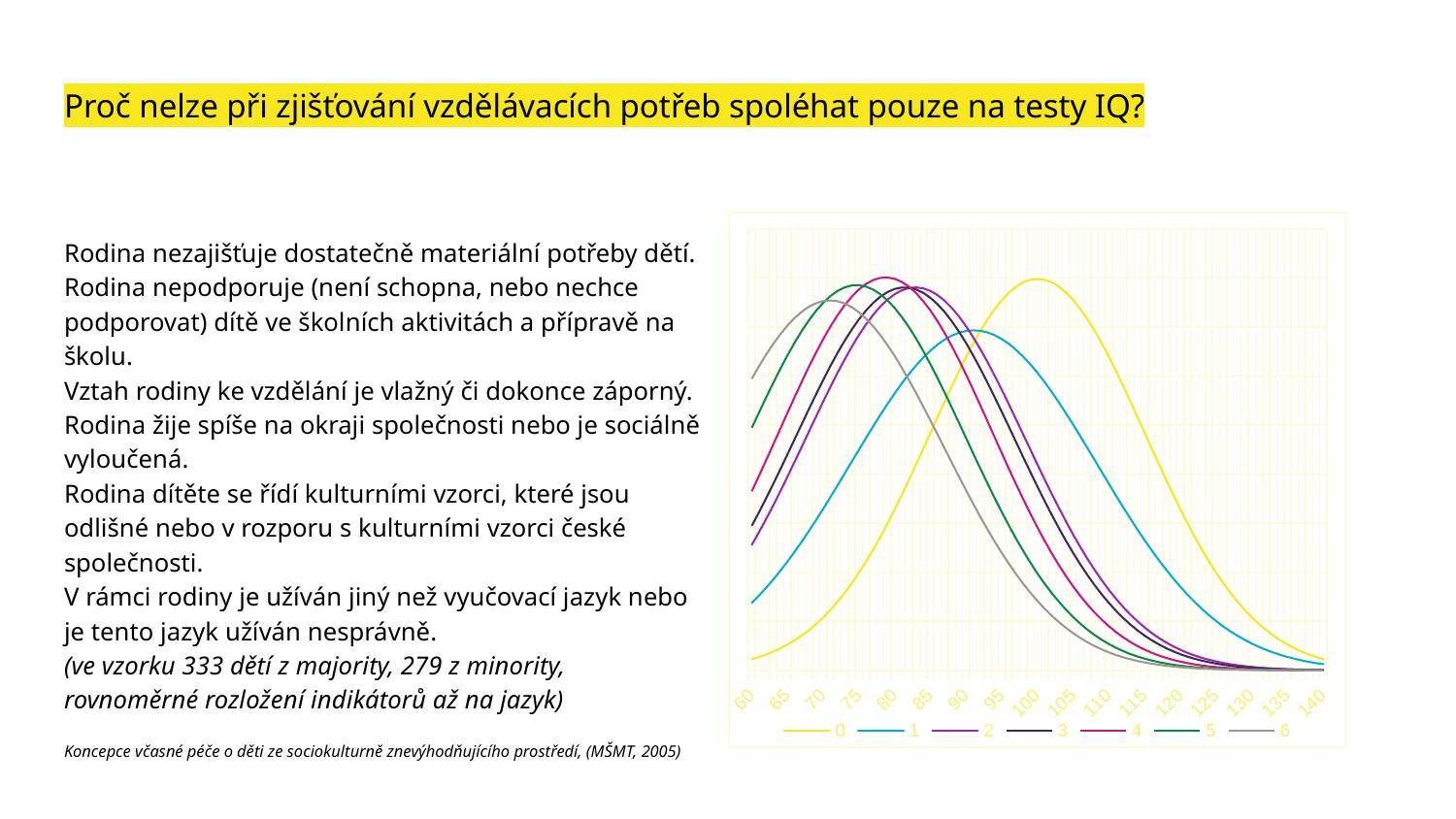
What entries are listed in the chart's legend? 0, 1, 2, 3, 4, 5, 6 What are the lowest and highest values labelled on the x axis of the chart? 60 and 140 Which series reaches its peak furthest to the left along the x axis? 6 Does series 0 rise or fall between x = 60 and x = 100? rise Which series has the lowest peak on the chart? 1 How many series does the chart's legend list? 7 Does series 6 rise or fall between x = 70 and x = 140? fall Which series peaks further to the right on the x axis, series 0 or series 1? 0 What colour is the line for series 0? yellow How many tick labels are shown on the x axis of the chart? 17 What kind of chart is shown on the slide? line chart Which series reaches its peak furthest to the right along the x axis? 0